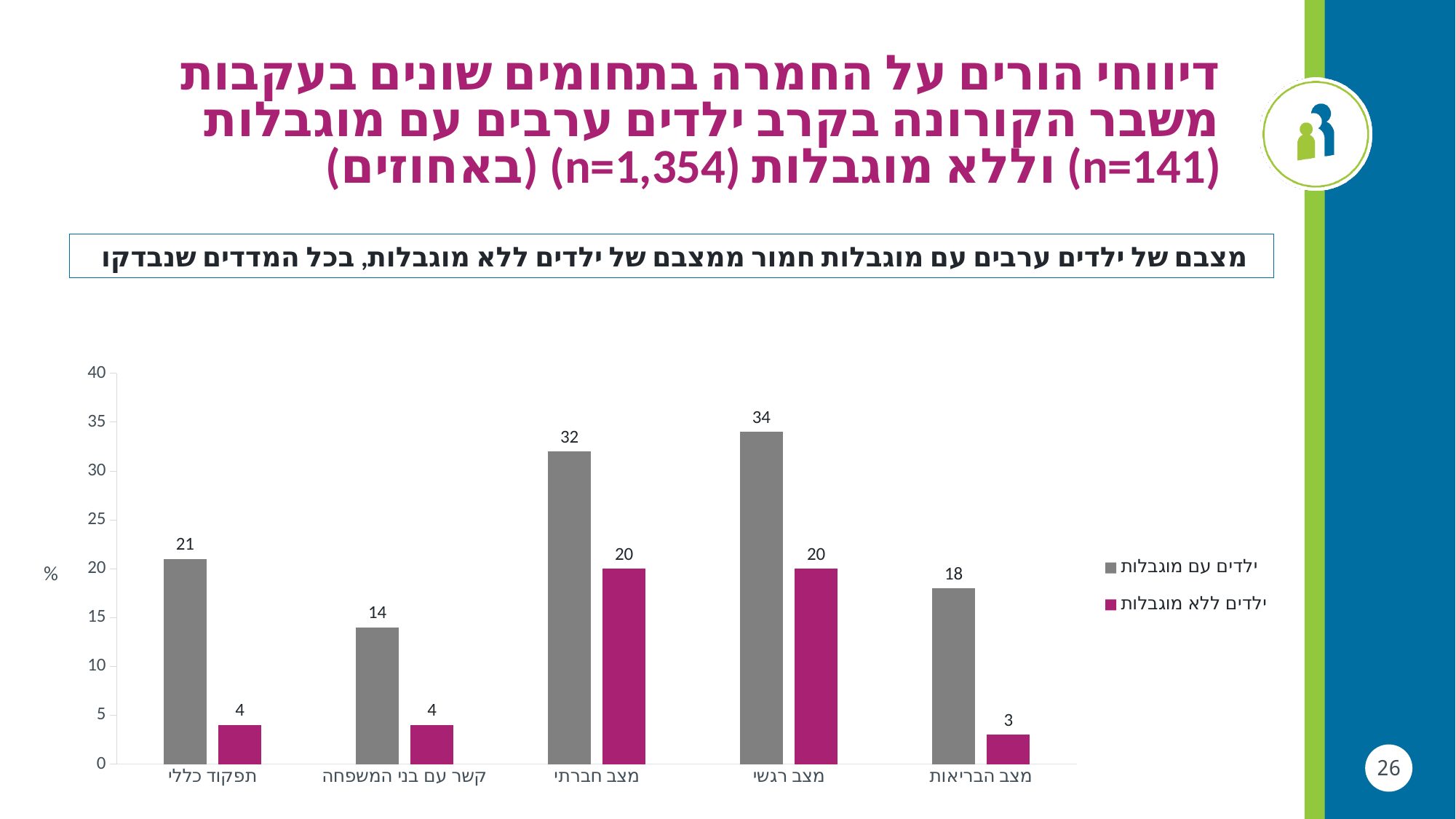
How many series does the chart legend list? 2 Which is larger in the תפקוד כללי category: the value for ילדים עם מוגבלות or for ילדים ללא מוגבלות? ילדים עם מוגבלות Which colour represents the ילדים ללא מוגבלות series in the chart? magenta What value is shown for ילדים עם מוגבלות in the קשר עם בני המשפחה category? 14 What value is shown for ילדים עם מוגבלות in the מצב רגשי category? 34 What is the difference between the ילדים עם מוגבלות and ילדים ללא מוגבלות values in the מצב חברתי category? 12 In which category is the value for ילדים ללא מוגבלות the lowest? מצב הבריאות How many categories are shown on the x axis of the chart? 5 What kind of chart is shown on the slide? bar chart What value is shown for ילדים ללא מוגבלות in the מצב הבריאות category? 3 Is the value for ילדים עם מוגבלות in the מצב חברתי category greater or less than 30? greater In which category is the value for ילדים עם מוגבלות the highest? מצב רגשי